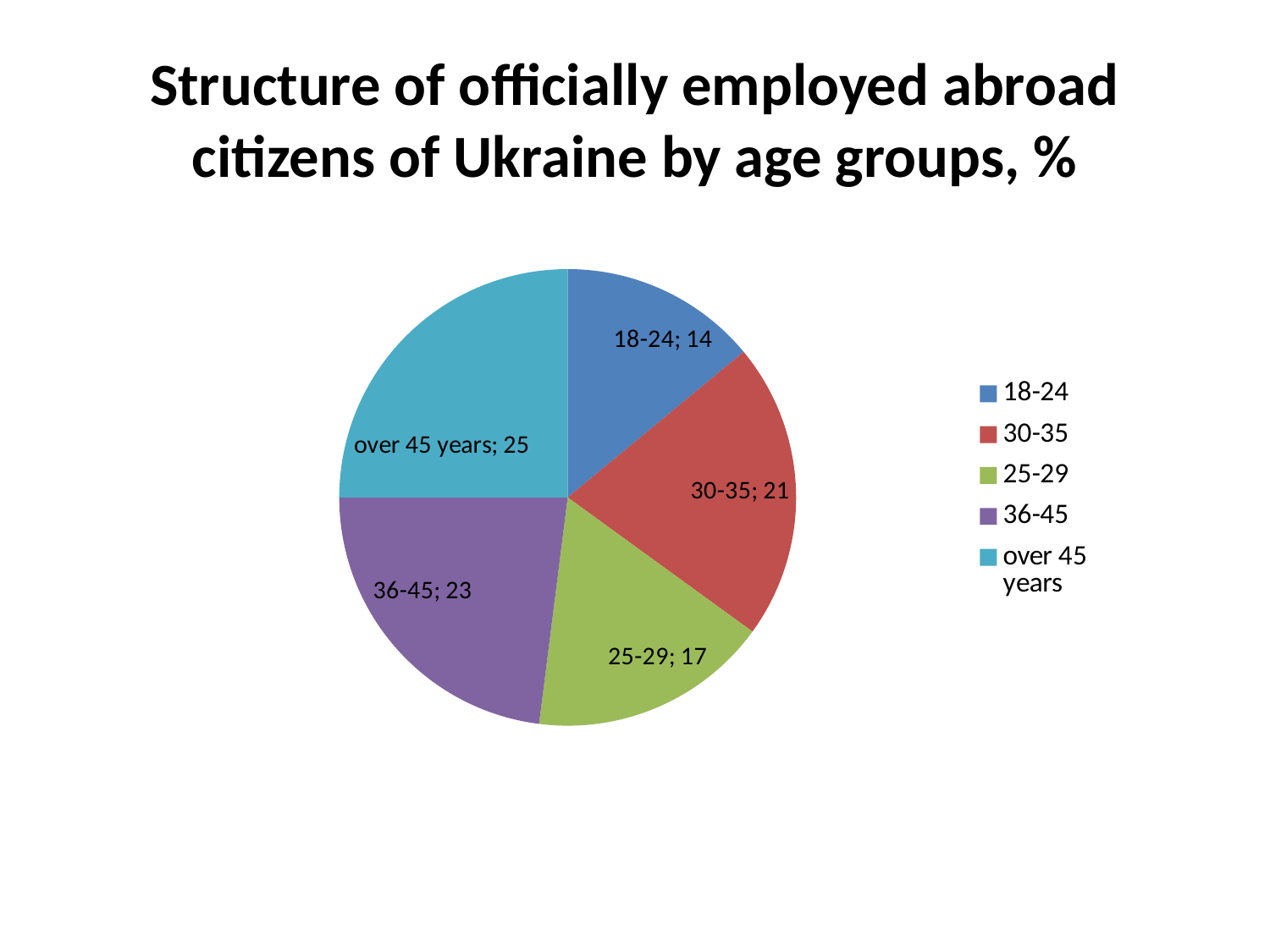
How many age groups are shown in the pie chart? 5 Which age group has the largest slice? over 45 years What is the value for the 18-24 age group? 14 Which is larger, the value for 30-35 or the value for 25-29? 30-35 What is the title of the chart? Structure of officially employed abroad citizens of Ukraine by age groups, % What is the difference between the values for 36-45 and 25-29? 6 Which age group has the smallest slice? 18-24 What colour is the slice for the 25-29 age group? green What is the value for the 30-35 age group? 21 What is the value for the 36-45 age group? 23 What is the difference between the values for over 45 years and 18-24? 11 What kind of chart is shown on the slide? pie chart